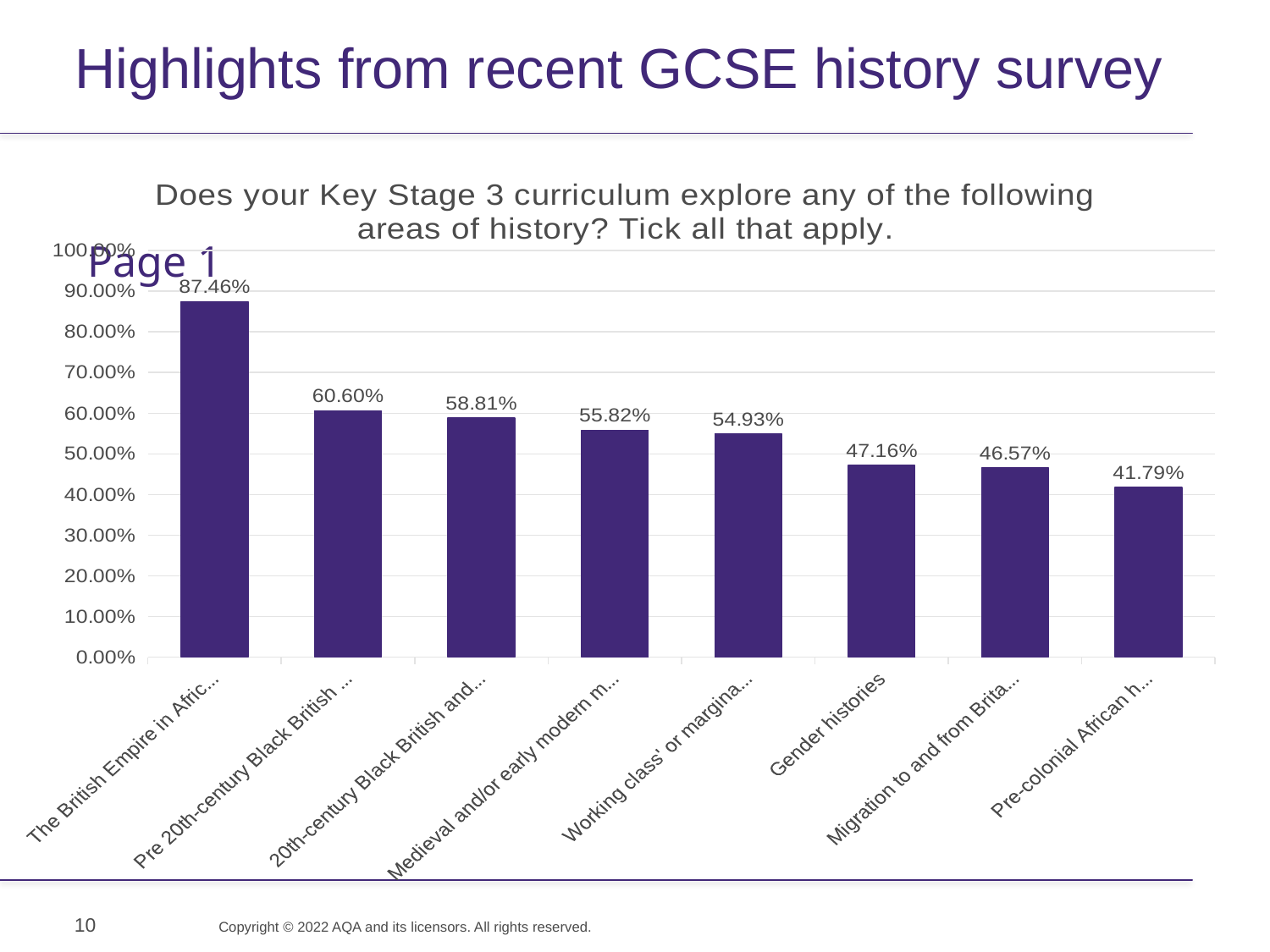
Which is larger: the value for Gender histories or the value for 'Pre-colonial African h...'? Gender histories What is the value for the last bar, labelled 'Pre-colonial African h...'? 41.79% What question is shown as the chart's title? Does your Key Stage 3 curriculum explore any of the following areas of history? Tick all that apply. Which category has the highest value? The British Empire in Afric... What kind of chart is shown on the slide? bar chart What is the value for Gender histories? 47.16% Do the bar values rise or fall from left to right across the chart? fall What is the difference between the highest value (87.46%) and the value for Gender histories (47.16%)? 40.30% What is the value for the bar labelled 'Migration to and from Brita...'? 46.57% What is the value for the first bar, labelled 'The British Empire in Afric...'? 87.46% How many bars are plotted in the chart? 8 Which category has the lowest value? Pre-colonial African h...